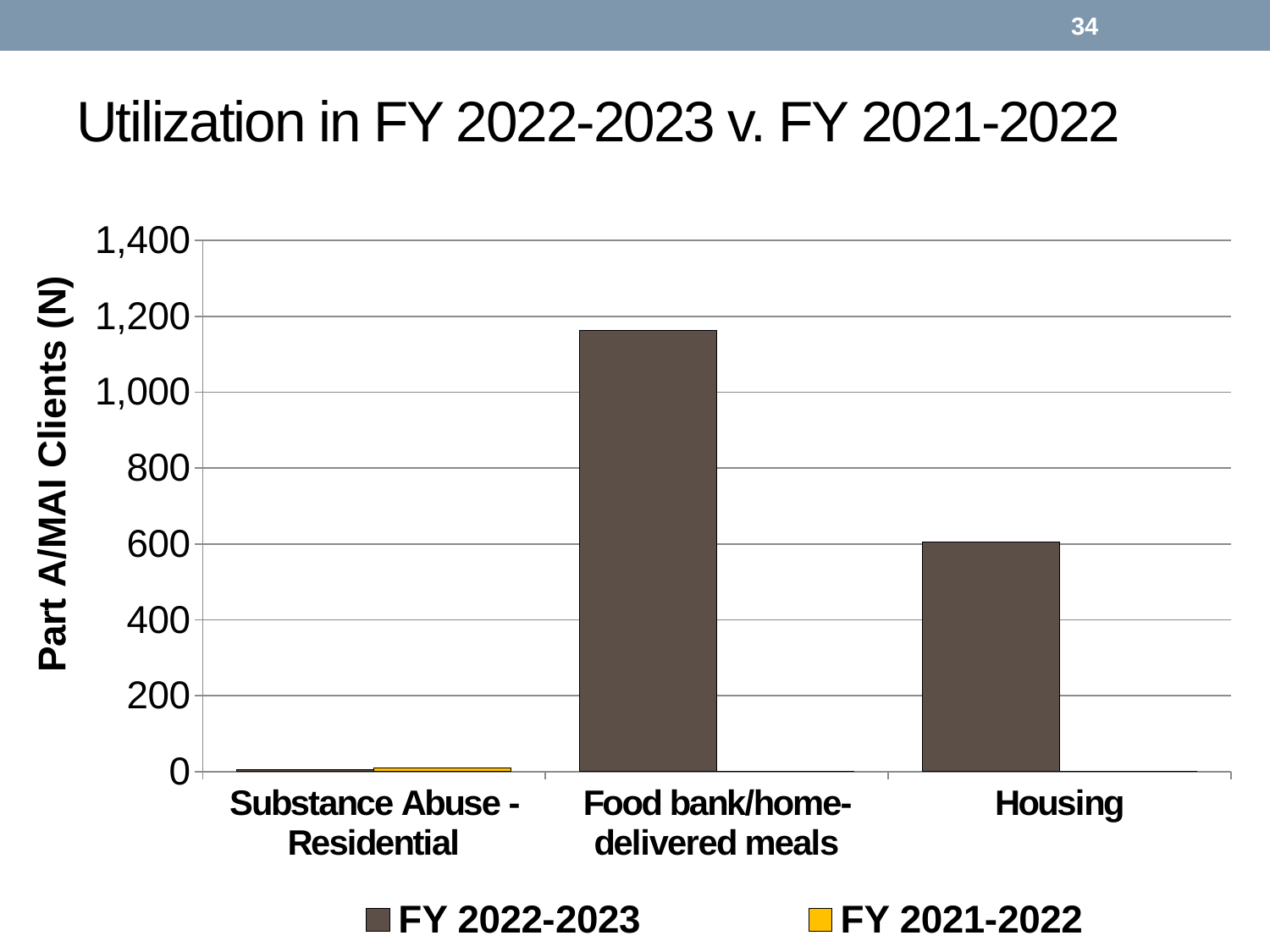
For FY 2022-2023, which is larger: Food bank/home-delivered meals or Housing? Food bank/home-delivered meals Is the FY 2022-2023 value for Substance Abuse - Residential greater or less than 200? less Which category has the lowest FY 2022-2023 value? Substance Abuse - Residential How many series does the legend list? 2 Which category has the highest FY 2022-2023 value? Food bank/home-delivered meals Is the FY 2022-2023 value for Food bank/home-delivered meals greater or less than 1,000? greater How many categories are shown on the x axis? 3 Is the FY 2022-2023 value for Housing greater or less than 800? less What is the label on the y axis? Part A/MAI Clients (N) Which series is shown in yellow in the legend? FY 2021-2022 What kind of chart is shown on the slide? bar chart